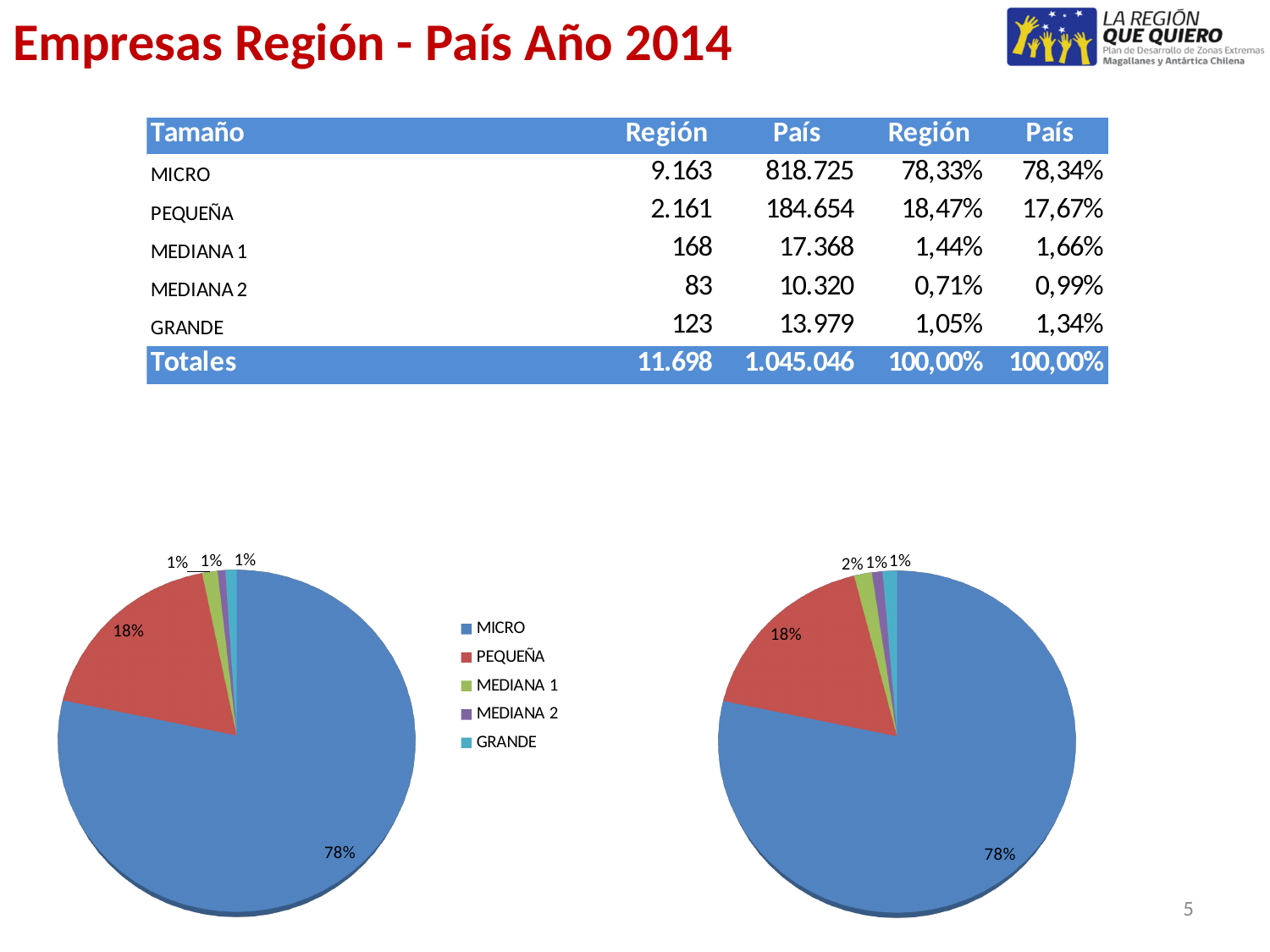
In the right pie chart, which is larger, MICRO or PEQUEÑA? MICRO What kind of chart is the chart on the left of the slide? pie chart How many slices does the left pie chart have? 5 In the left pie chart, what is the difference in percentage points between the MICRO and PEQUEÑA slices? 60 percentage points What colour represents MICRO in the pie charts? blue In the right pie chart, what share does PEQUEÑA have? 18% In the left pie chart, what share does PEQUEÑA have? 18% How many entries does the legend between the two pie charts list? 5 In the right pie chart, what share does MEDIANA 1 have? 2% Which category has the largest slice in the left pie chart? MICRO